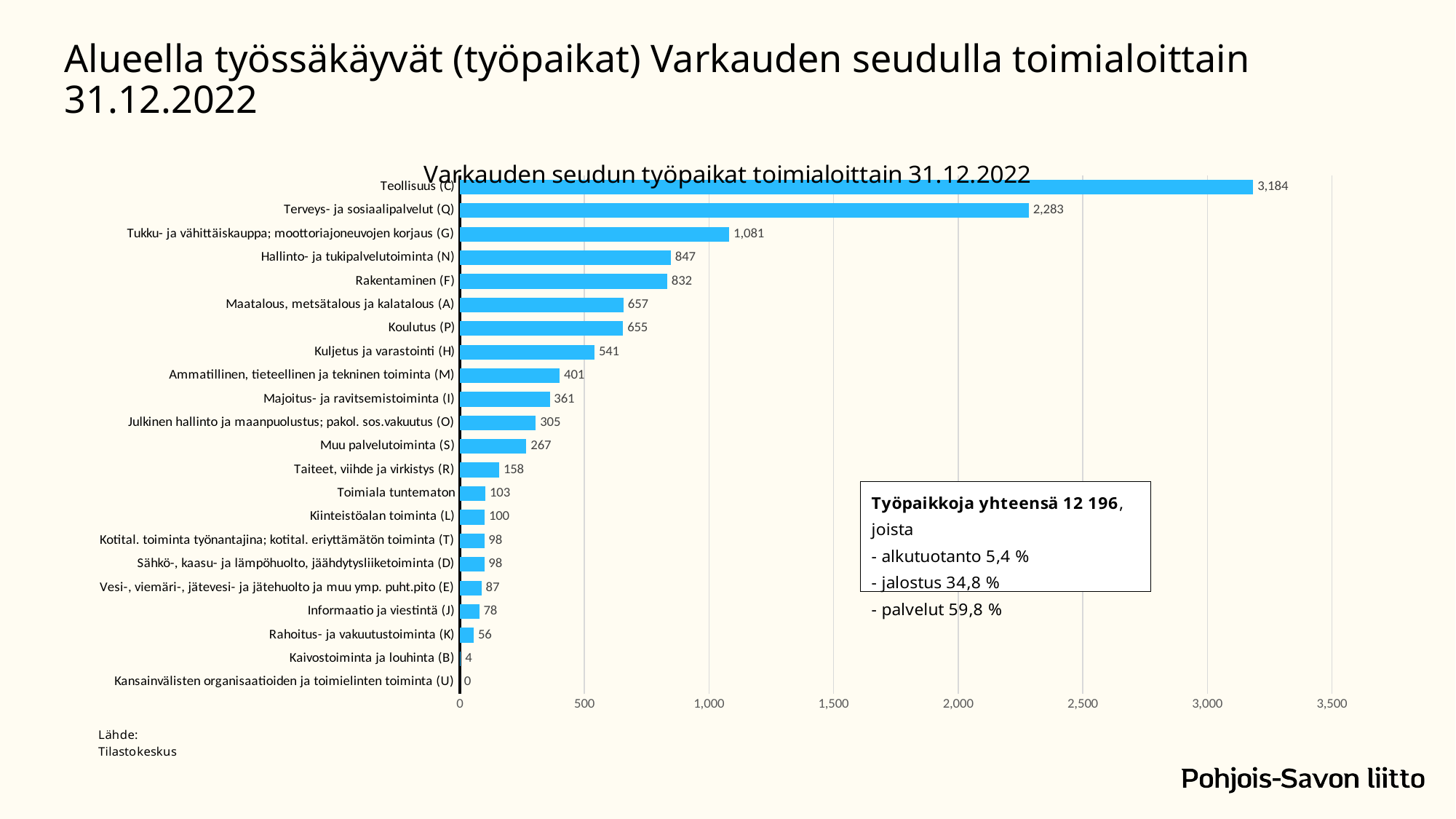
What is the title of the chart? Varkauden seudun työpaikat toimialoittain 31.12.2022 What is the difference between Teollisuus (C) and Terveys- ja sosiaalipalvelut (Q)? 901 How many jobs are shown for Teollisuus (C)? 3,184 How many industry categories are shown in the chart? 22 Which industry has the lowest number of jobs? Kansainvälisten organisaatioiden ja toimielinten toiminta (U) What type of chart is shown on the slide? bar chart Is the value for Kuljetus ja varastointi (H) greater or less than 500? greater What is the value for Koulutus (P)? 655 Which industry has the highest number of jobs? Teollisuus (C) What is the value for Rakentaminen (F)? 832 What is the value for Kaivostoiminta ja louhinta (B)? 4 Which is larger, Hallinto- ja tukipalvelutoiminta (N) or Kuljetus ja varastointi (H)? Hallinto- ja tukipalvelutoiminta (N)